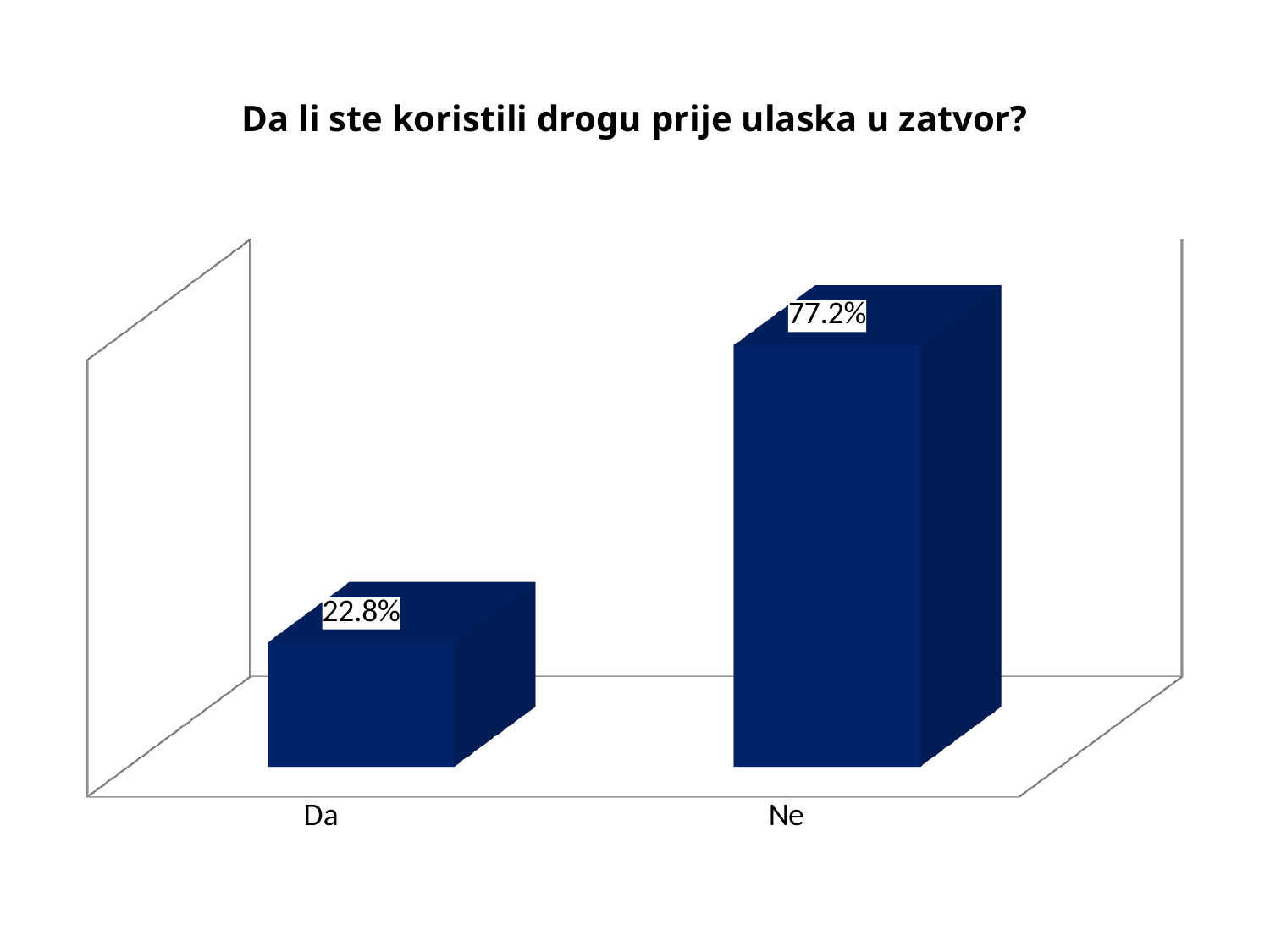
What is the difference between the values for "Ne" and "Da"? 54.4% What is the value for "Ne"? 77.2% What colour are the bars in the chart? Dark blue Which category has the highest value? Ne Which category has the lowest value? Da What is the total of the two values shown in the chart? 100% What is the title of the chart? Da li ste koristili drogu prije ulaska u zatvor? Which is larger, the value for "Da" or the value for "Ne"? Ne How many categories are shown in the chart? 2 What is the value for "Da"? 22.8% What kind of chart is shown on the slide? Bar chart